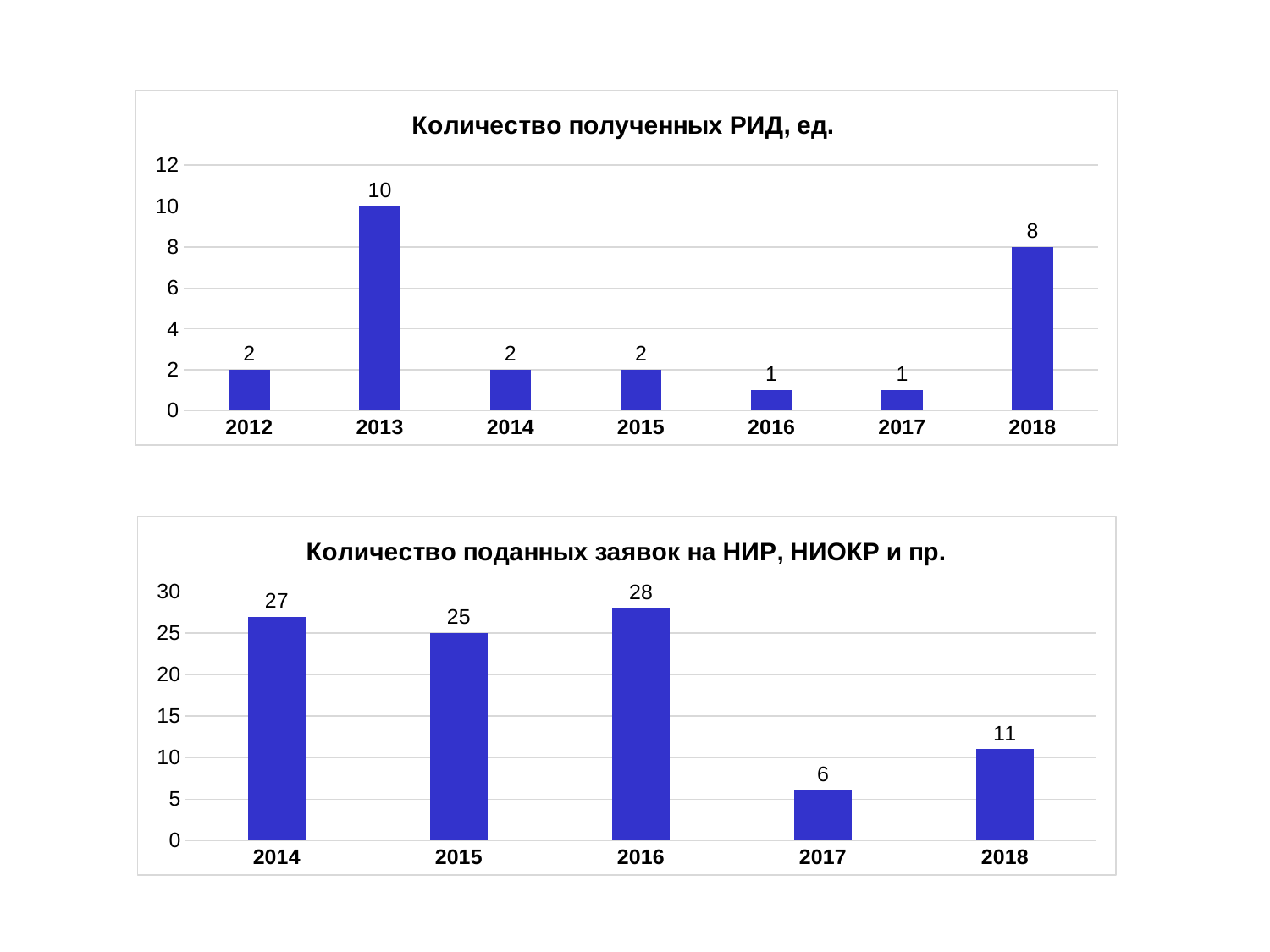
In the bottom chart "Количество поданных заявок на НИР, НИОКР и пр.", which year has the lowest value? 2017 What kind of chart is the top chart "Количество полученных РИД, ед."? Bar chart In the bottom chart "Количество поданных заявок на НИР, НИОКР и пр.", how many years are shown on the x axis? 5 In the top chart "Количество полученных РИД, ед.", which year has the highest value? 2013 In the bottom chart "Количество поданных заявок на НИР, НИОКР и пр.", what is the difference between the values for 2016 and 2017? 22 In the top chart "Количество полученных РИД, ед.", what is the value for 2016? 1 In the top chart "Количество полученных РИД, ед.", what is the value for 2013? 10 In the bottom chart "Количество поданных заявок на НИР, НИОКР и пр.", which is larger, the value for 2014 or the value for 2018? 2014 In the bottom chart "Количество поданных заявок на НИР, НИОКР и пр.", what is the value for 2015? 25 In the bottom chart "Количество поданных заявок на НИР, НИОКР и пр.", which year has the highest value? 2016 In the top chart "Количество полученных РИД, ед.", how many years are shown on the x axis? 7 In the top chart "Количество полученных РИД, ед.", what is the difference between the values for 2013 and 2018? 2